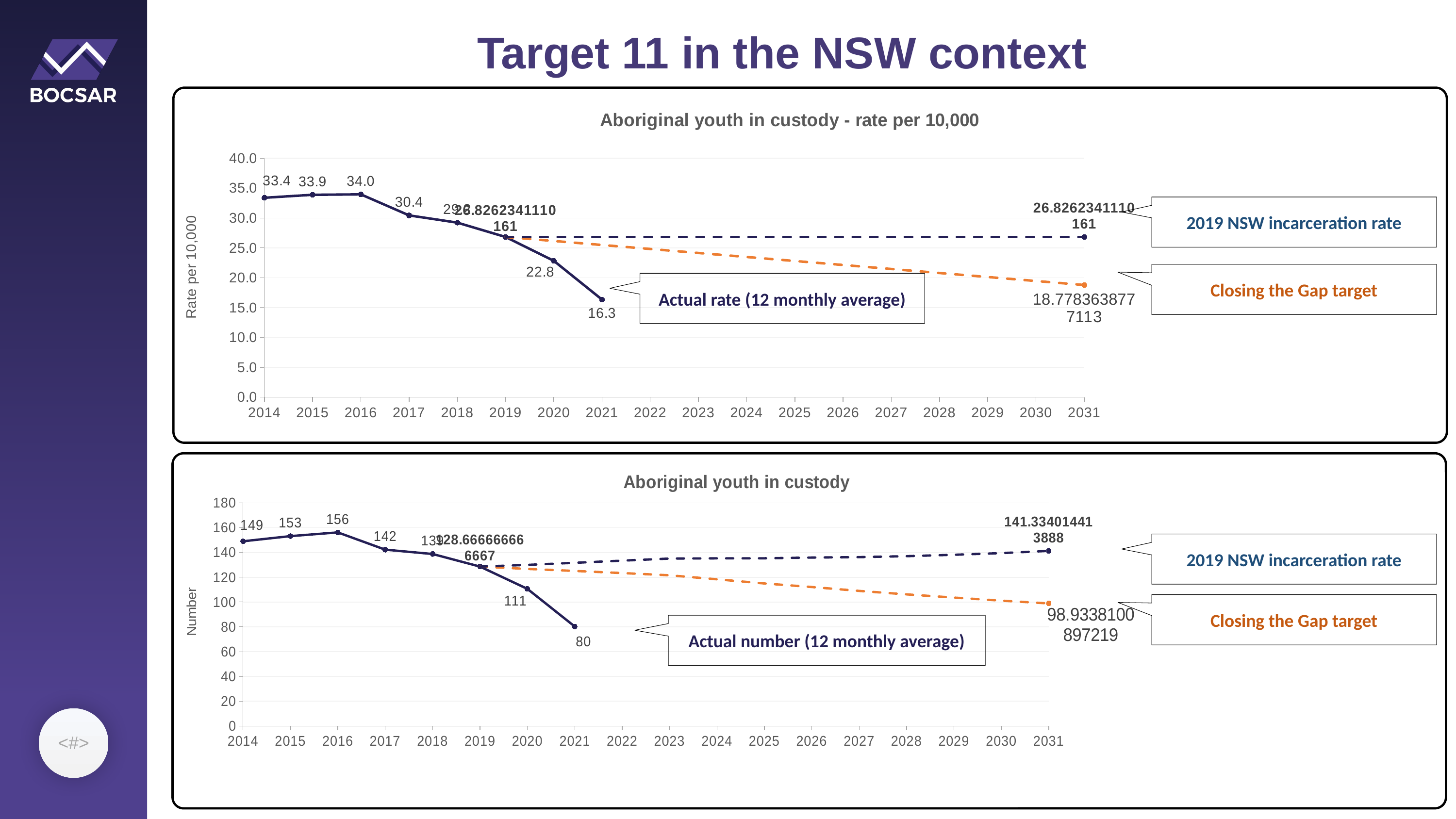
In the top chart (Aboriginal youth in custody - rate per 10,000), which year has the lowest actual rate? 2021 In the bottom chart (Aboriginal youth in custody), what is the value for 2016? 156 In the top chart (Aboriginal youth in custody - rate per 10,000), what is the difference between the 2014 value and the 2017 value? 3.0 In the bottom chart (Aboriginal youth in custody), which is larger, the value for 2017 or the value for 2020? 2017 In the bottom chart (Aboriginal youth in custody), what is the difference between the 2015 value and the 2020 value? 42 In the bottom chart (Aboriginal youth in custody), what is the value for 2021? 80 In the top chart (Aboriginal youth in custody - rate per 10,000), what is the value for 2016? 34.0 In the top chart (Aboriginal youth in custody - rate per 10,000), what kind of chart is shown? Line chart In the bottom chart (Aboriginal youth in custody), what is the label of the orange dashed line? Closing the Gap target In the top chart (Aboriginal youth in custody - rate per 10,000), which year has the highest actual rate? 2016 In the bottom chart (Aboriginal youth in custody), does the actual number rise or fall from 2016 to 2021? Fall In the top chart (Aboriginal youth in custody - rate per 10,000), what is the value for 2021? 16.3